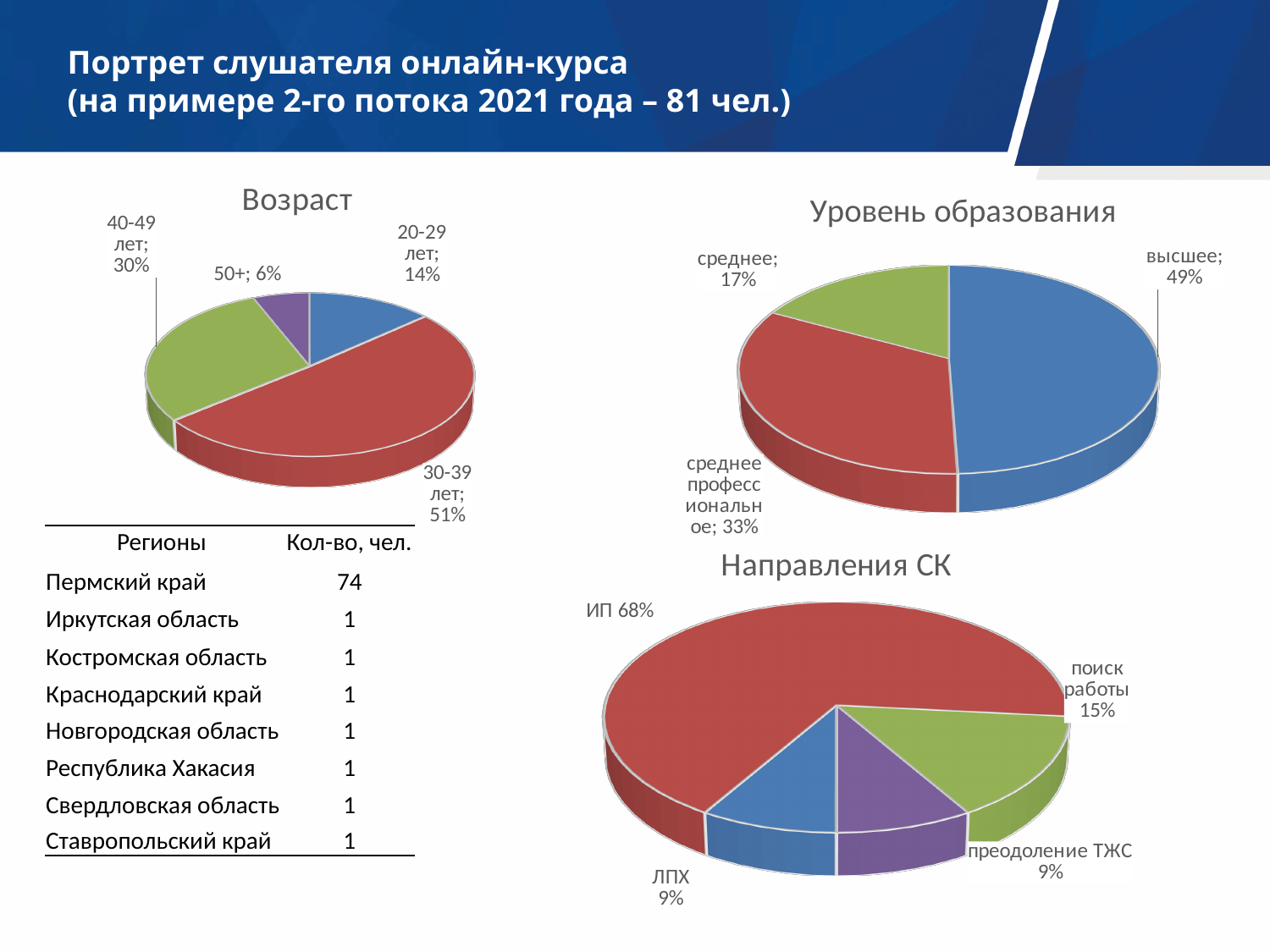
In the "Направления СК" chart, how many slices does the pie have? 4 In the "Уровень образования" chart, what share is shown for "высшее"? 49% In the "Возраст" chart, what is the difference in percentage points between the "40-49 лет" and "20-29 лет" slices? 16 What type of chart is "Направления СК"? pie chart In the "Направления СК" chart, what share is shown for "ИП"? 68% In the "Направления СК" chart, what is the difference in percentage points between "ИП" and "поиск работы"? 53 In the "Возраст" chart, what share is shown for the "30-39 лет" slice? 51% In the "Возраст" chart, how many slices does the pie have? 4 In the "Уровень образования" chart, which is larger: "среднее профессиональное" or "среднее"? среднее профессиональное In the "Возраст" chart, which age group has the smallest share? 50+ In the "Уровень образования" chart, which category has the largest share? высшее How many pie charts are shown on the slide? 3